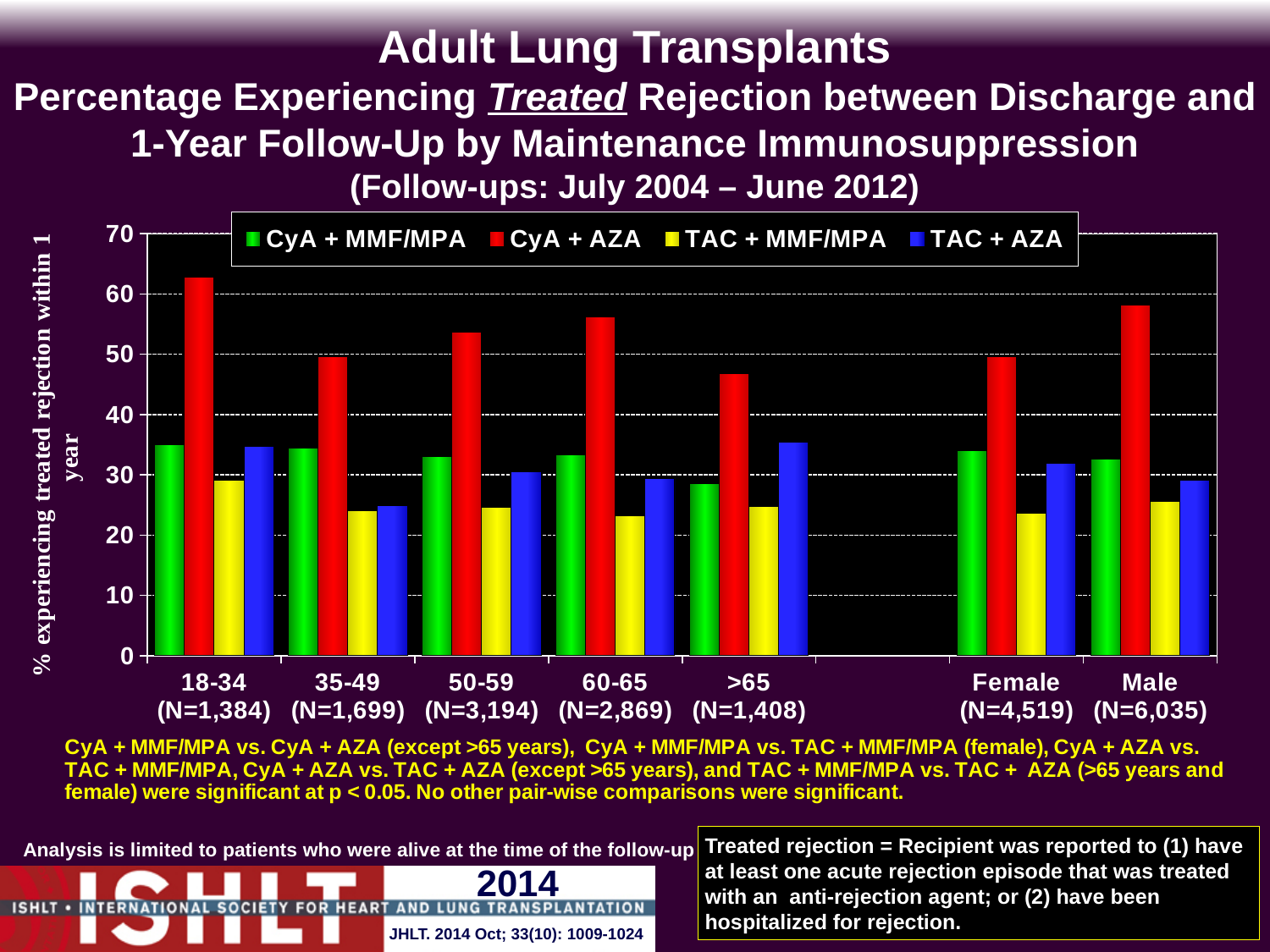
How many series does the legend list? 4 Is the value for TAC + MMF/MPA in the 60-65 group greater or less than 30? less Which series has the lowest value in the Female category? TAC + MMF/MPA In the >65 group, which is larger, TAC + AZA or CyA + MMF/MPA? TAC + AZA Is the value for CyA + AZA in the 18-34 group greater or less than 60? greater Is the value for CyA + AZA in the >65 group greater or less than 50? less What colour represents CyA + AZA in the legend? red Which series has the highest value in every category? CyA + AZA What kind of chart is shown on the slide? bar chart Which is larger, the CyA + AZA value for Male or for Female? Male How many categories are shown along the x axis? 7 Which age group has the highest value for CyA + AZA? 18-34